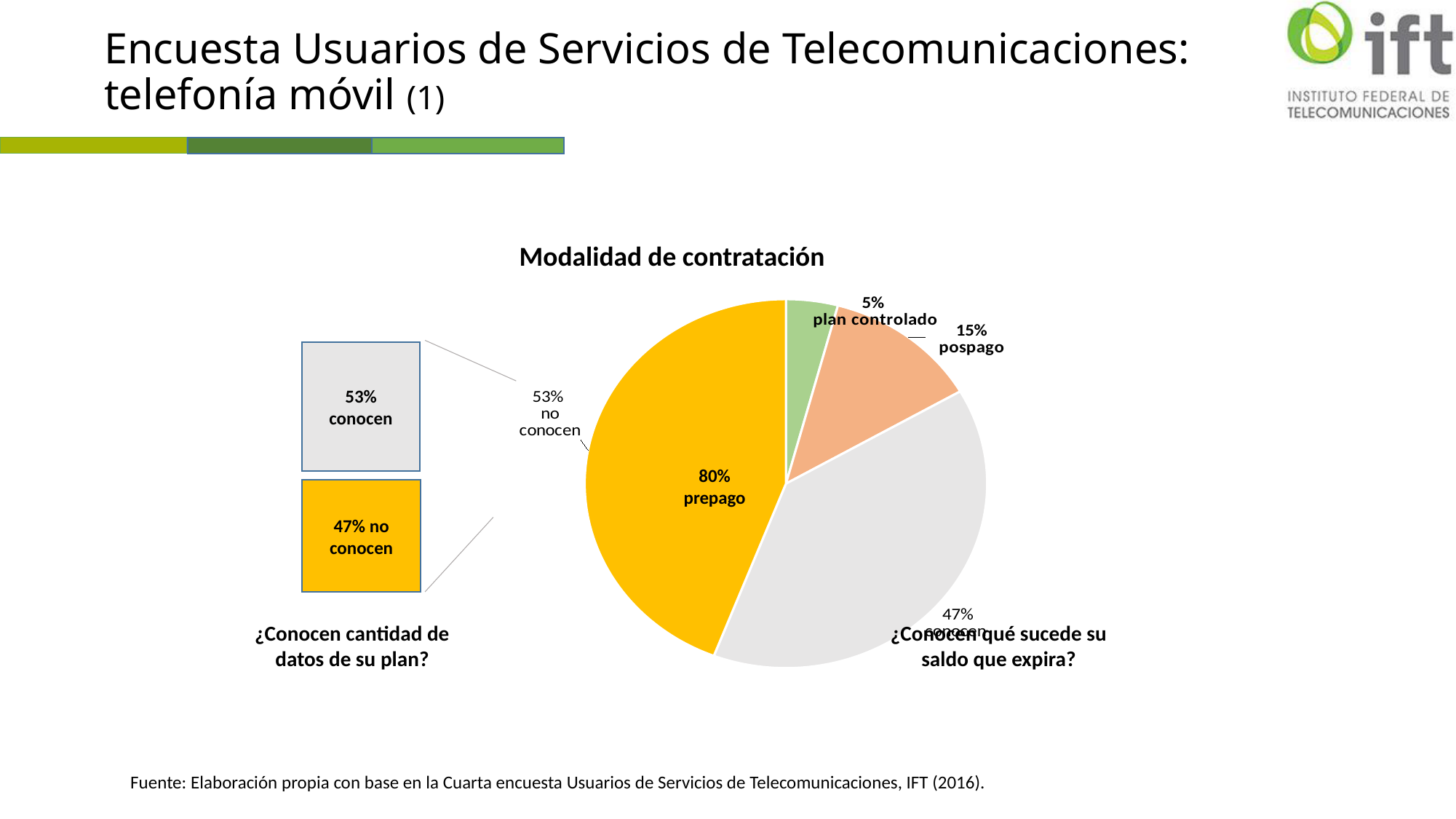
In the "Modalidad de contratación" pie chart, which is larger, pospago or plan controlado? pospago What is the title of the pie chart? Modalidad de contratación How many contract modalities are shown as slices in the "Modalidad de contratación" pie chart? 3 In the "Modalidad de contratación" pie chart, what share is labelled for plan controlado? 5% In the "Modalidad de contratación" pie chart, what share is labelled for pospago? 15% What kind of chart is shown under the title "Modalidad de contratación"? pie chart In the "Modalidad de contratación" pie chart, what is the difference in percentage points between prepago and pospago? 65 Which slice of the "Modalidad de contratación" pie chart is the smallest? plan controlado In the "Modalidad de contratación" pie chart, what percentage of prepago users is labelled as "no conocen" regarding what happens to their expiring balance? 53% Which slice of the "Modalidad de contratación" pie chart is the largest? prepago In the "Modalidad de contratación" pie chart, what share is labelled for prepago? 80% In the "Modalidad de contratación" pie chart, what colour is the prepago slice? yellow